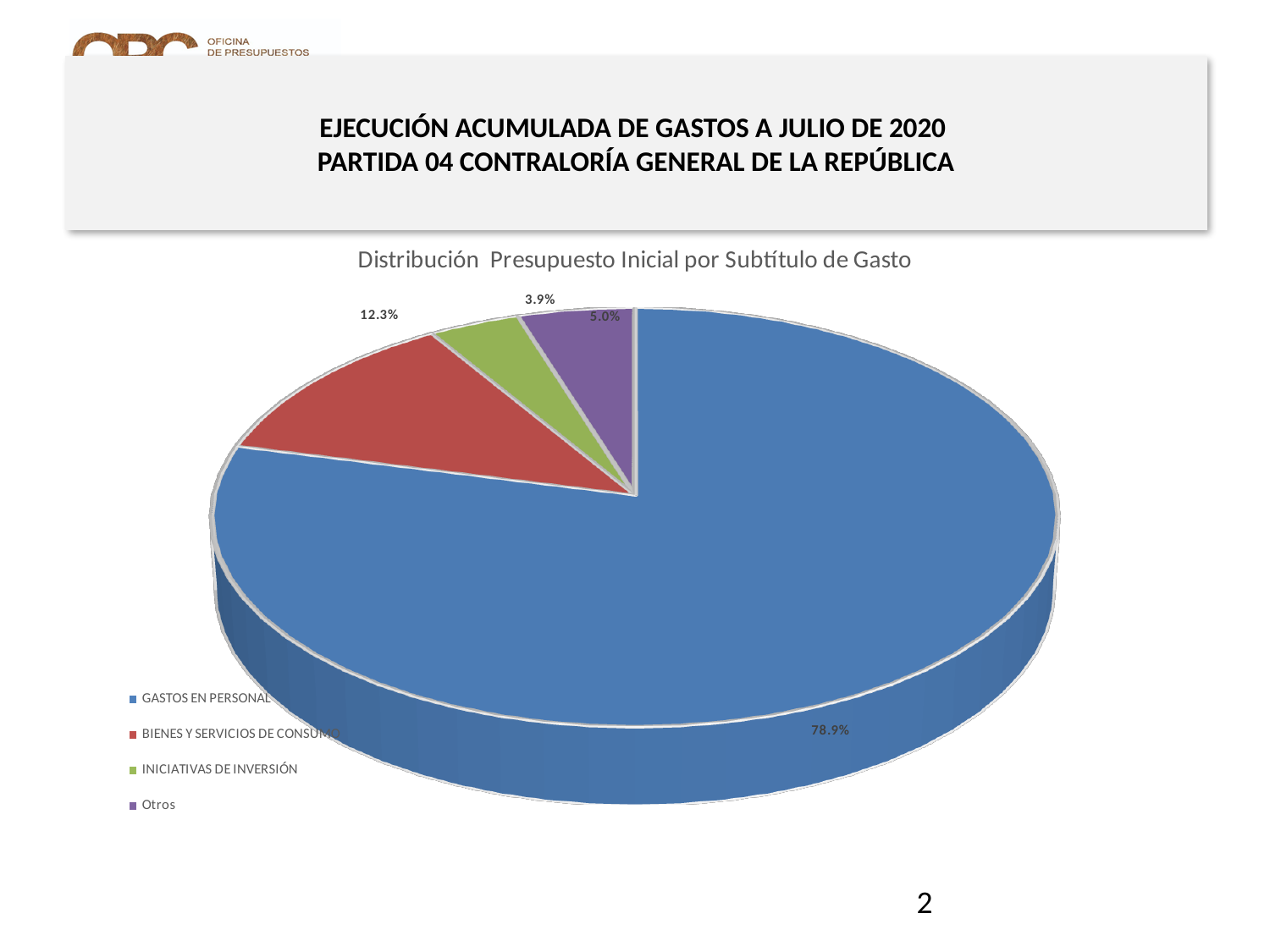
Which is larger, the Otros slice or the INICIATIVAS DE INVERSIÓN slice? Otros How many entries does the legend list? 4 What percentage is shown for BIENES Y SERVICIOS DE CONSUMO? 12.3% What is the title of the chart? Distribución Presupuesto Inicial por Subtítulo de Gasto How many slices does the pie chart have? 4 What is the difference in percentage points between GASTOS EN PERSONAL and BIENES Y SERVICIOS DE CONSUMO? 66.6 What kind of chart is shown on the slide? Pie chart What percentage is shown for INICIATIVAS DE INVERSIÓN? 3.9% What share of the pie does GASTOS EN PERSONAL represent? 78.9% Which category has the largest slice of the pie? GASTOS EN PERSONAL What percentage is shown for the Otros slice? 5.0% Which category has the smallest slice of the pie? INICIATIVAS DE INVERSIÓN